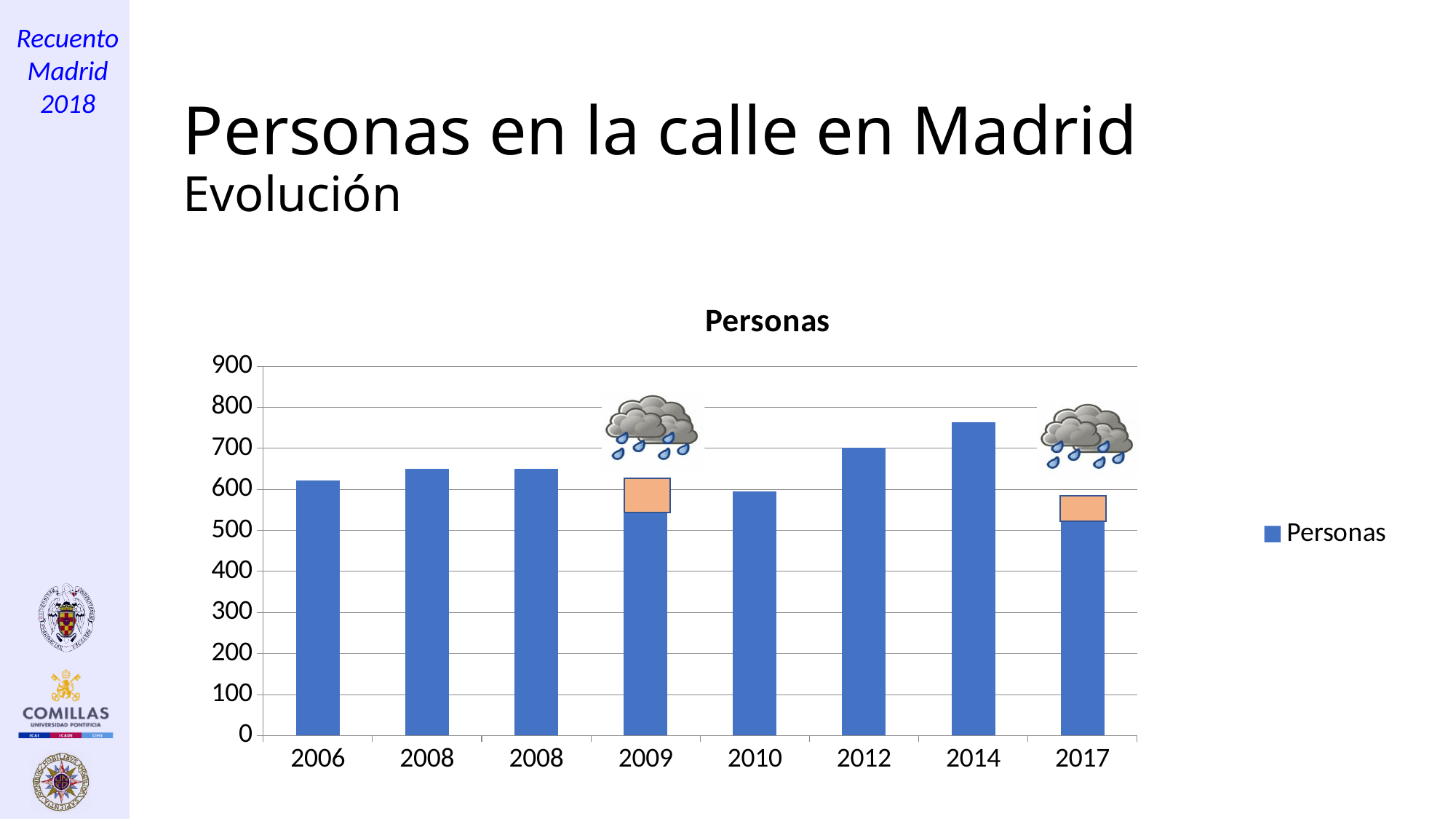
How many series does the legend list? 1 What is the title of the chart? Personas Is the blue bar for 2009 greater or less than 600? less Is the value for 2014 greater or less than 800? less Is the blue bar for 2017 greater or less than 600? less Does the value rise or fall from 2014 to 2017? fall Which is larger, the value for 2012 or the value for 2014? 2014 Which is larger, the value for 2006 or the value for 2012? 2012 How many bars are plotted in the chart? 8 What kind of chart is shown on the slide? bar chart Which year has the highest value in the chart? 2014